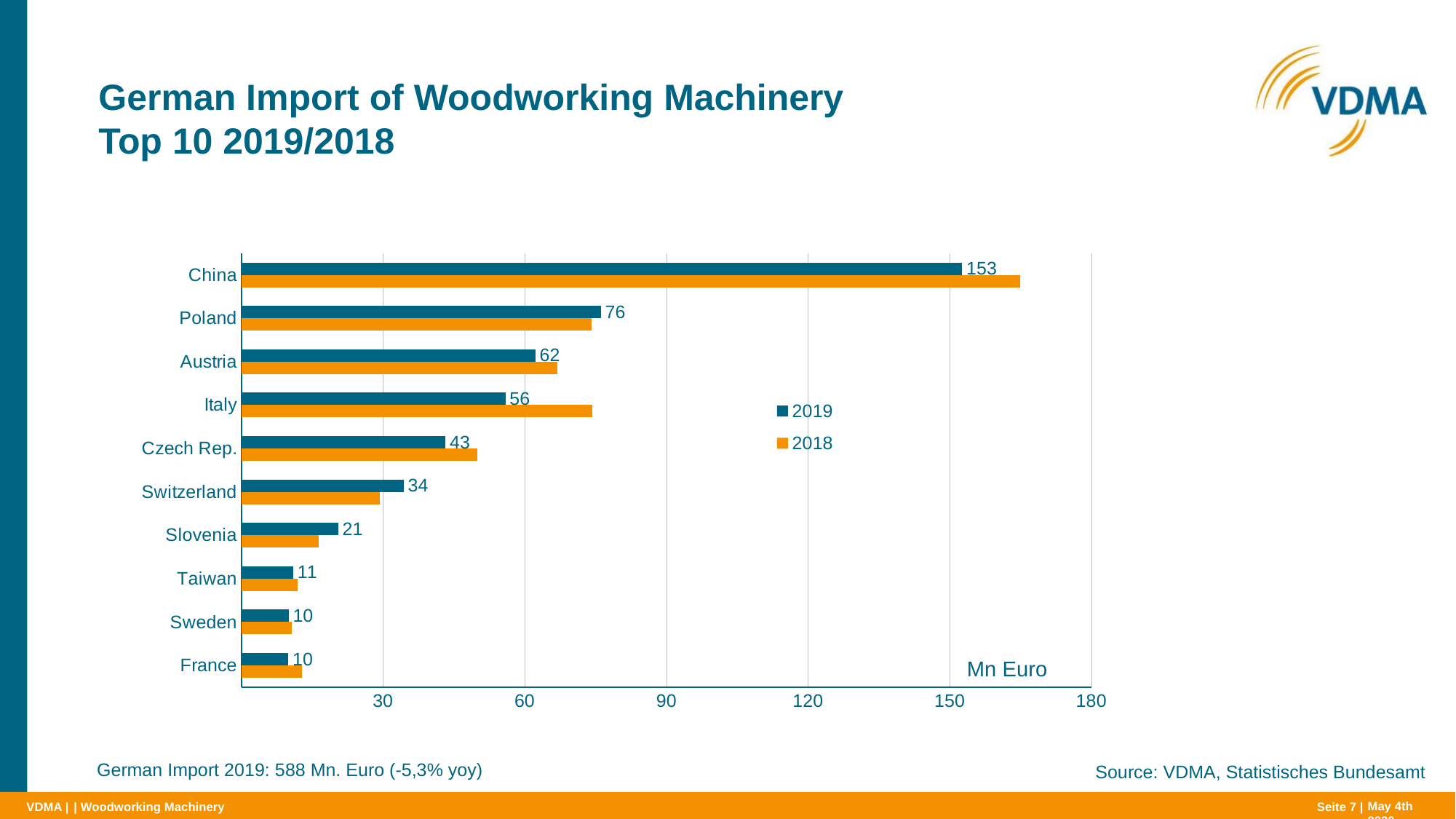
For Italy, which is larger, the 2019 value or the 2018 value? 2018 What is the difference between the 2019 values for China and Italy? 97 How many series does the legend list? 2 What kind of chart is shown on the slide? Bar chart For Switzerland, which is larger, the 2019 value or the 2018 value? 2019 Is the 2018 value for China greater or less than 150? greater Which country has the highest 2019 value? China What is the 2019 value for China? 153 What is the 2019 value for Slovenia? 21 What is the 2019 value for Czech Rep.? 43 What is the difference between the 2019 values for Poland and Austria? 14 How many countries are shown in the chart? 10